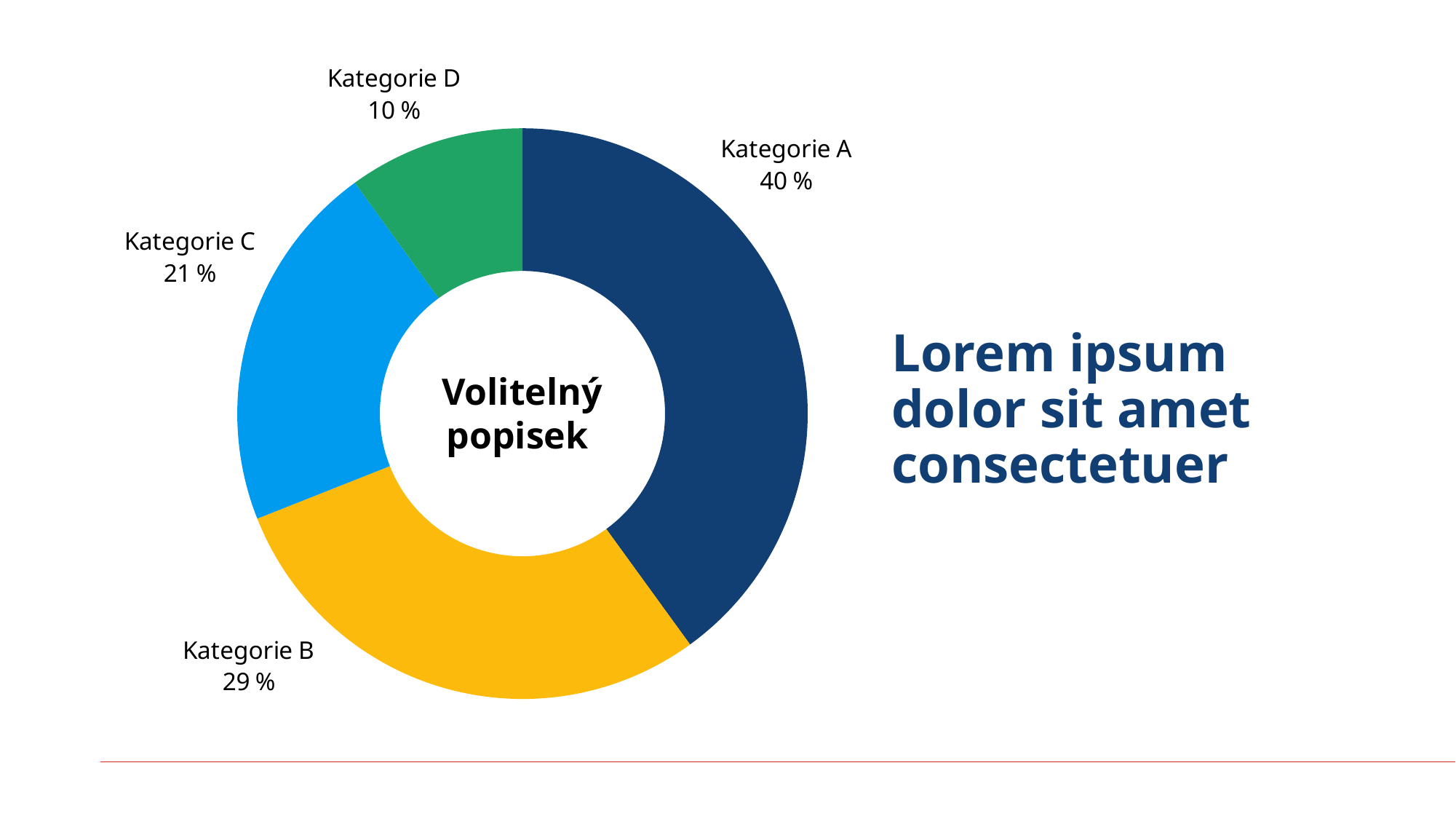
What is the value for Kategorie C? 21 % What is the value for Kategorie D? 10 % What is the difference between the values for Kategorie A and Kategorie B? 11 % What colour is the slice for Kategorie B? Yellow What kind of chart is shown on the slide? Doughnut (pie) chart What text is shown in the centre of the doughnut chart? Volitelný popisek Which category has the smallest share? Kategorie D How many categories are shown in the chart? 4 What is the value for Kategorie A? 40 % Which is larger, Kategorie C or Kategorie D? Kategorie C Which category has the largest share? Kategorie A What is the value for Kategorie B? 29 %